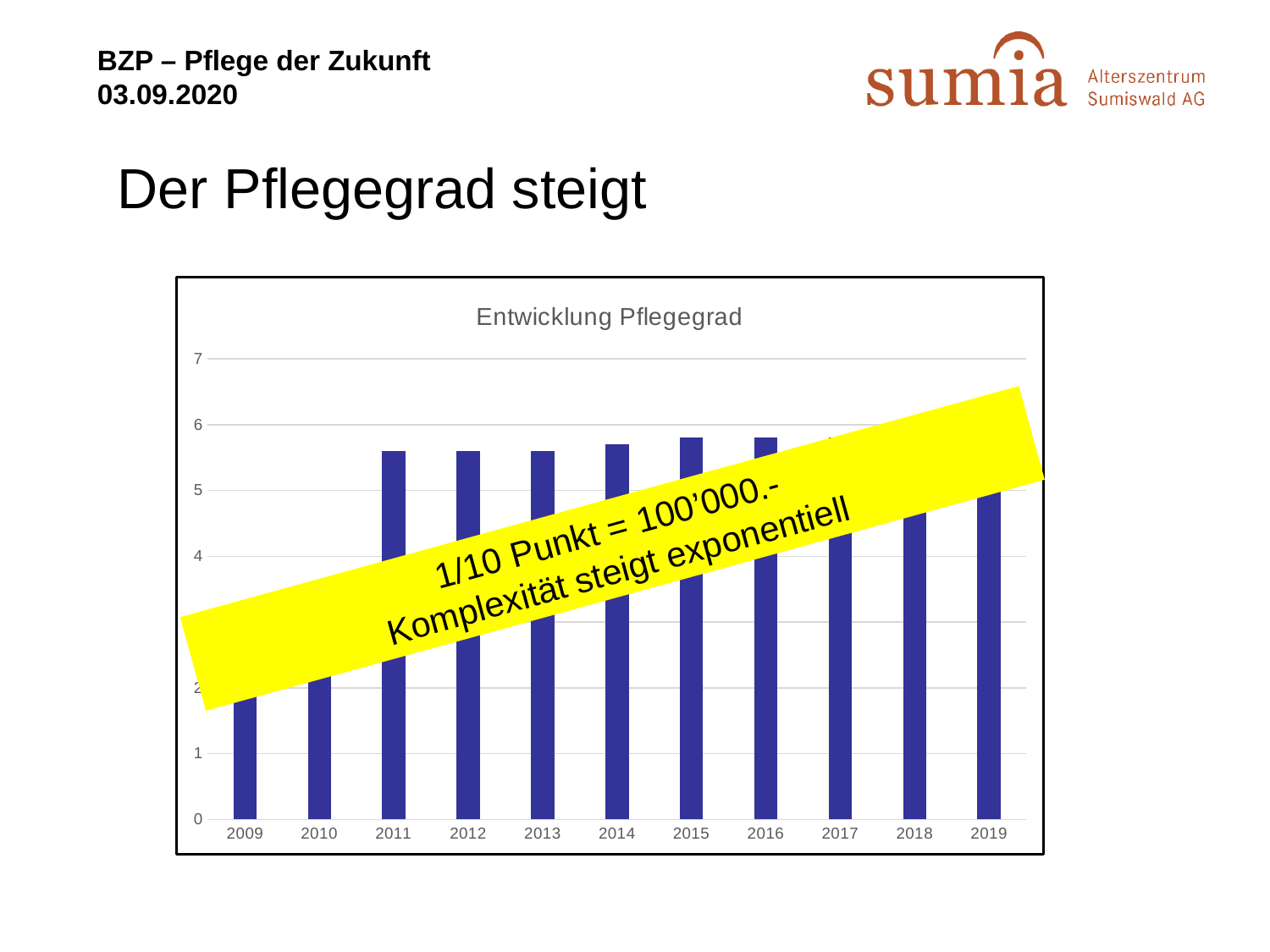
What is the first year shown on the x axis of the chart? 2009 Is the value for 2011 greater or less than 5? greater Do the values generally rise or fall from 2009 to 2016? rise Is the value for 2010 greater or less than 4? less Which is larger, the value for 2010 or the value for 2015? 2015 Which is larger, the value for 2009 or the value for 2011? 2011 What is the title of the chart? Entwicklung Pflegegrad How many years are shown on the x axis of the chart? 11 What type of chart is shown on the slide? bar chart Is the value for 2015 greater or less than 6? less